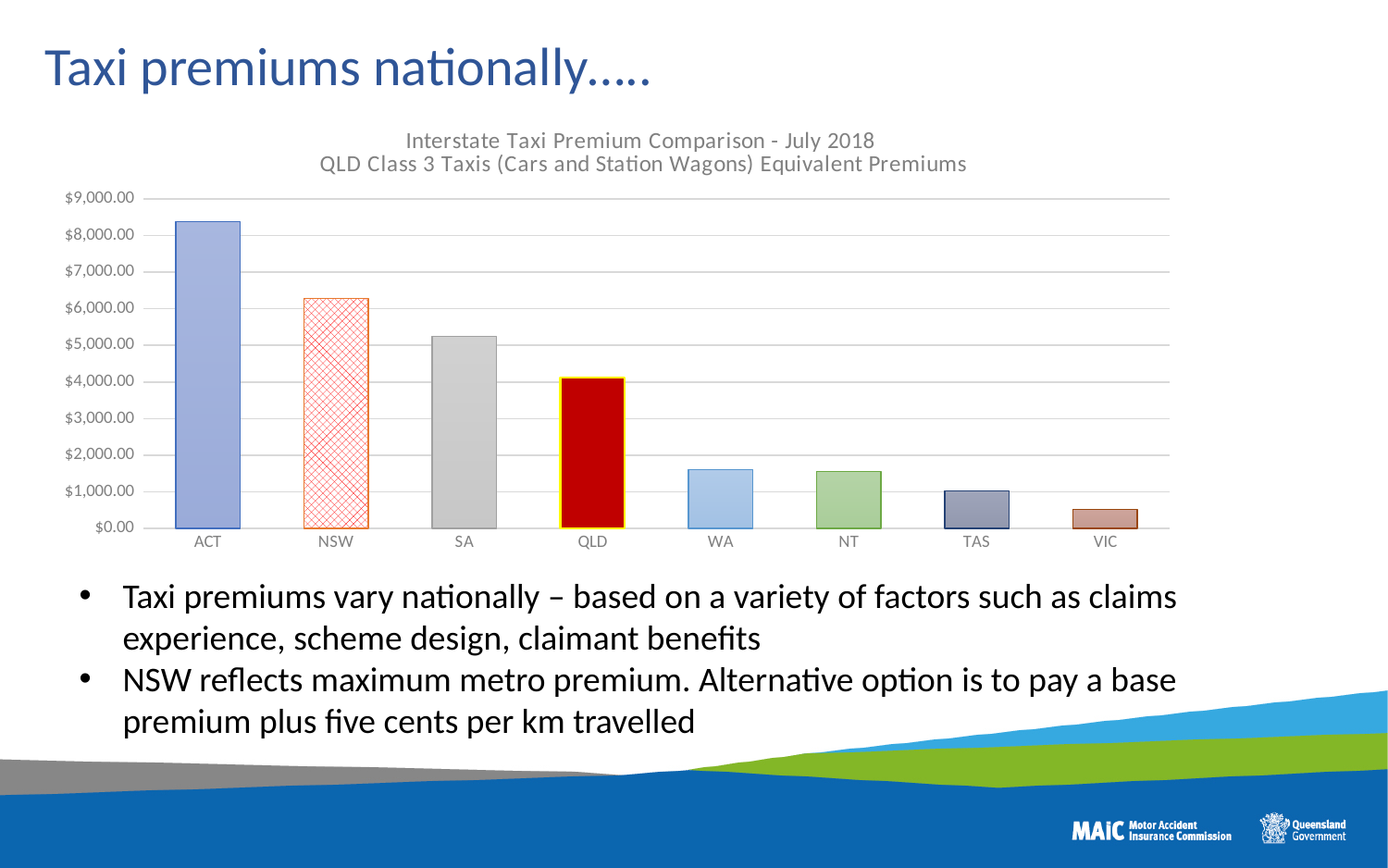
Is the value for VIC greater or less than $1,000.00? less What is the first line of the chart's title? Interstate Taxi Premium Comparison - July 2018 What kind of chart is shown on the slide? bar chart Which state or territory has the highest taxi premium in the chart? ACT Which has the larger taxi premium, TAS or NSW? NSW Is the value for SA greater or less than $6,000.00? less Is the value for WA greater or less than $2,000.00? less Which state or territory has the lowest taxi premium in the chart? VIC Which has the larger taxi premium, SA or QLD? SA How many states and territories are shown on the x axis of the chart? 8